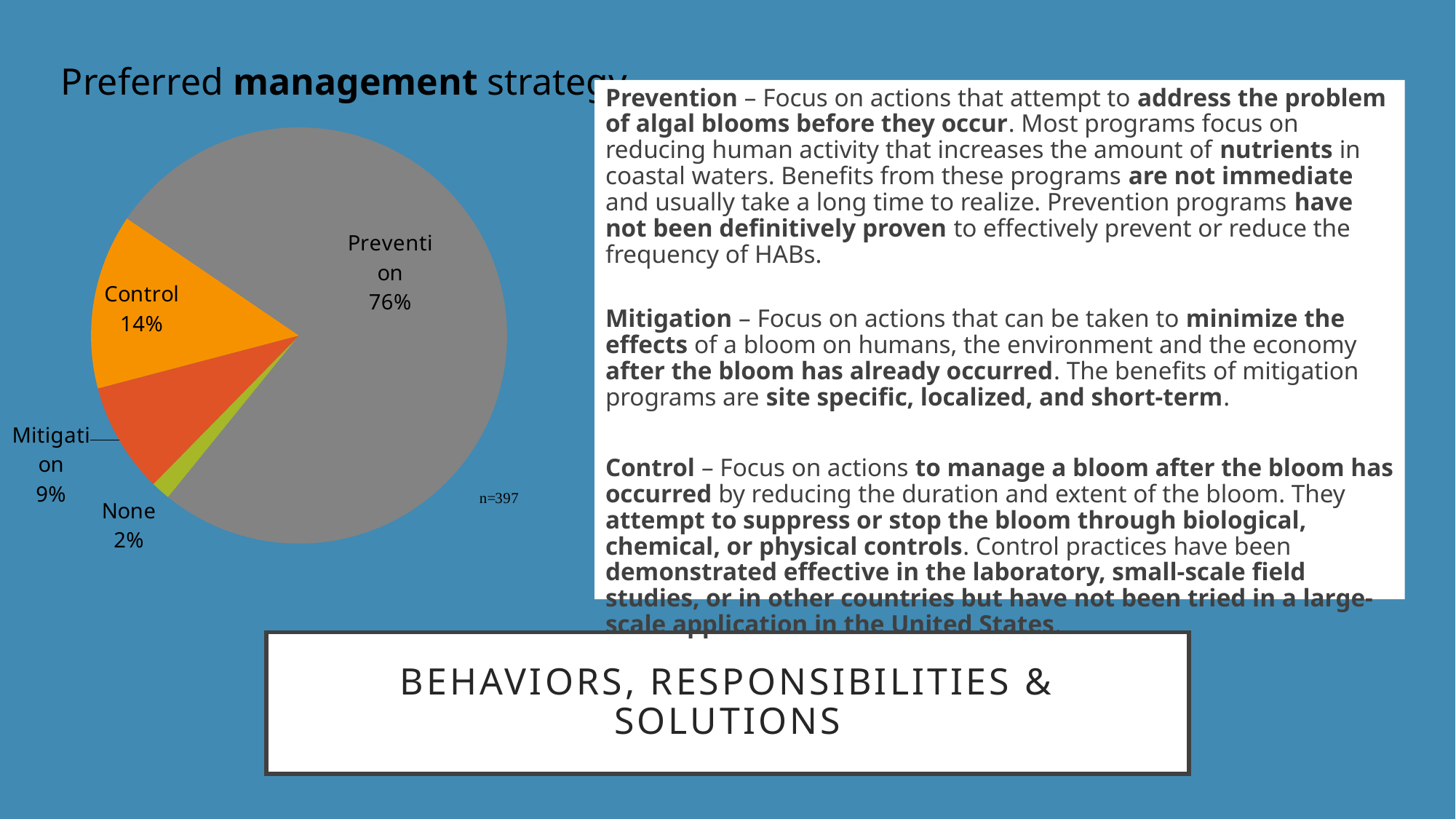
What is the difference in percentage points between Prevention and Control? 62 What sample size (n) is noted on the chart? n=397 What type of chart is shown on the slide? pie chart What is the difference in percentage points between Control and Mitigation? 5 What share of the pie does Prevention account for? 76% How many slices does the pie chart have? 4 What percentage is shown for None? 2% Which is larger, the share for Control or the share for Mitigation? Control Which management strategy has the smallest slice of the pie? None What percentage is shown for Control? 14% Which management strategy has the largest slice of the pie? Prevention What percentage is shown for Mitigation? 9%